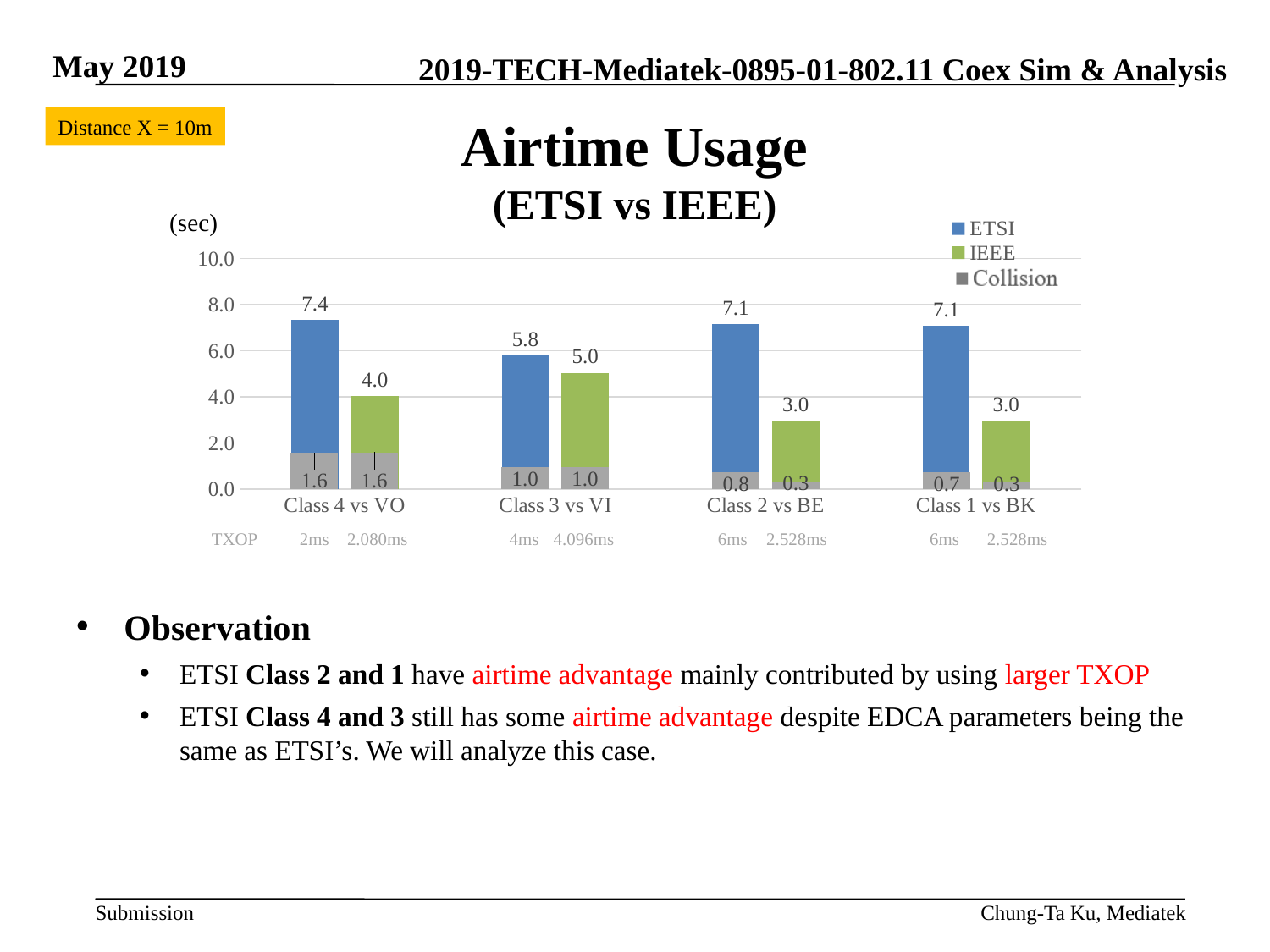
What is the Collision value shown on the ETSI bar for Class 1 vs BK? 0.7 How many categories are shown along the x axis of the chart? 4 Which category has the highest labelled ETSI bar? Class 4 vs VO Which category has the highest labelled IEEE bar? Class 3 vs VI What is the difference between the ETSI bar labels for Class 4 vs VO and Class 3 vs VI? 1.6 How many series does the chart legend list? 3 What value is labelled on the IEEE bar for Class 3 vs VI? 5.0 What value is labelled on the IEEE bar for Class 2 vs BE? 3.0 Which category has the lowest labelled ETSI bar? Class 3 vs VI For Class 3 vs VI, which bar is taller, ETSI or IEEE? ETSI What value is labelled on the ETSI bar for Class 4 vs VO? 7.4 What kind of chart is shown on the slide? bar chart